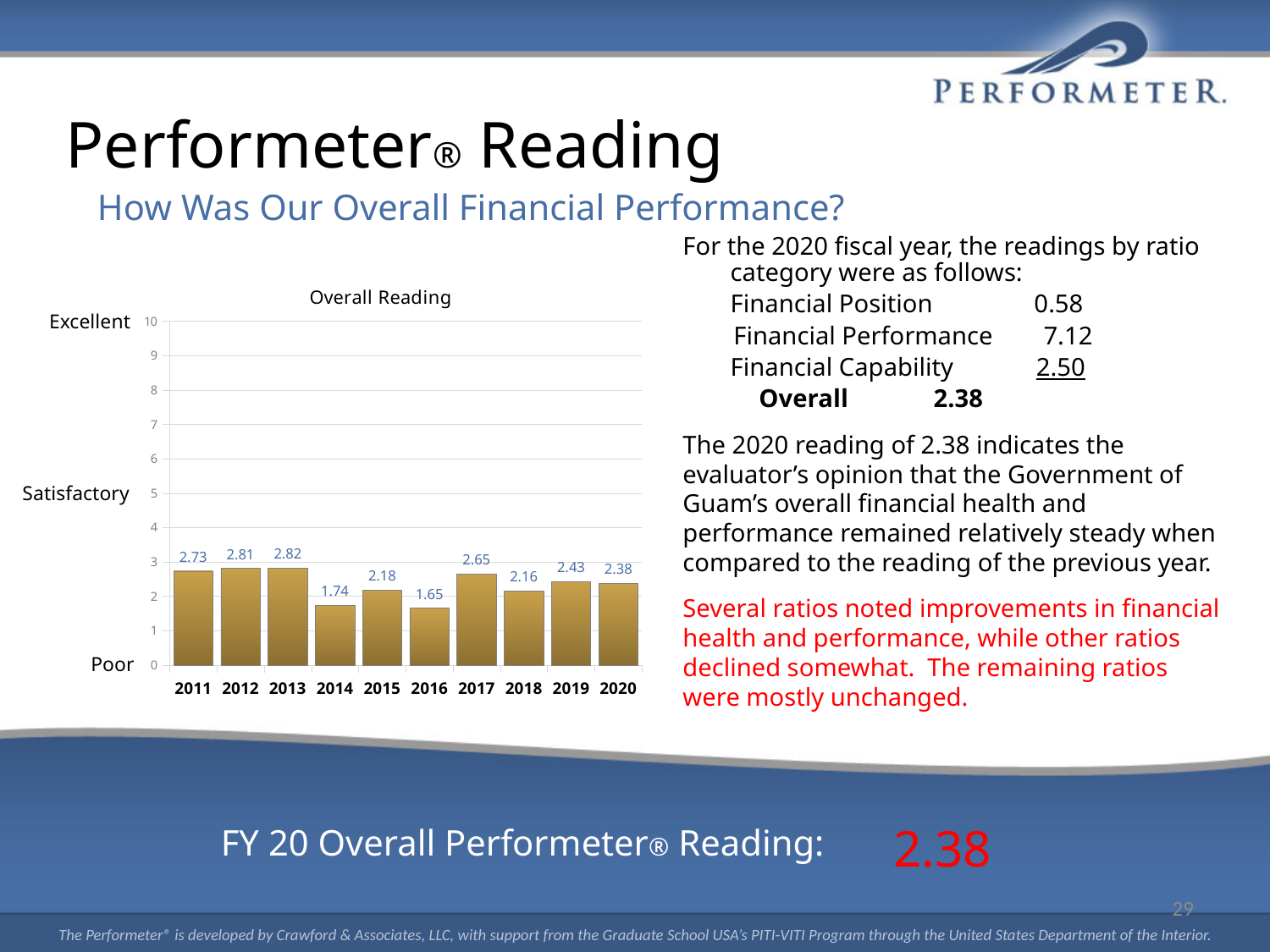
What is the Overall Reading value for 2020? 2.38 Is the Overall Reading for 2018 greater or less than 5? less What is the Overall Reading value for 2016? 1.65 What is the difference between the Overall Reading for 2019 and 2020? 0.05 What is the title of the chart? Overall Reading Did the Overall Reading rise or fall from 2013 to 2014? fall What label appears at the top of the y axis (at 10) on the chart? Excellent Which year has the lowest Overall Reading? 2016 What kind of chart is the Overall Reading chart? bar chart Which year has a higher Overall Reading, 2014 or 2017? 2017 Which year has the highest Overall Reading? 2013 How many years are shown on the x axis of the Overall Reading chart? 10